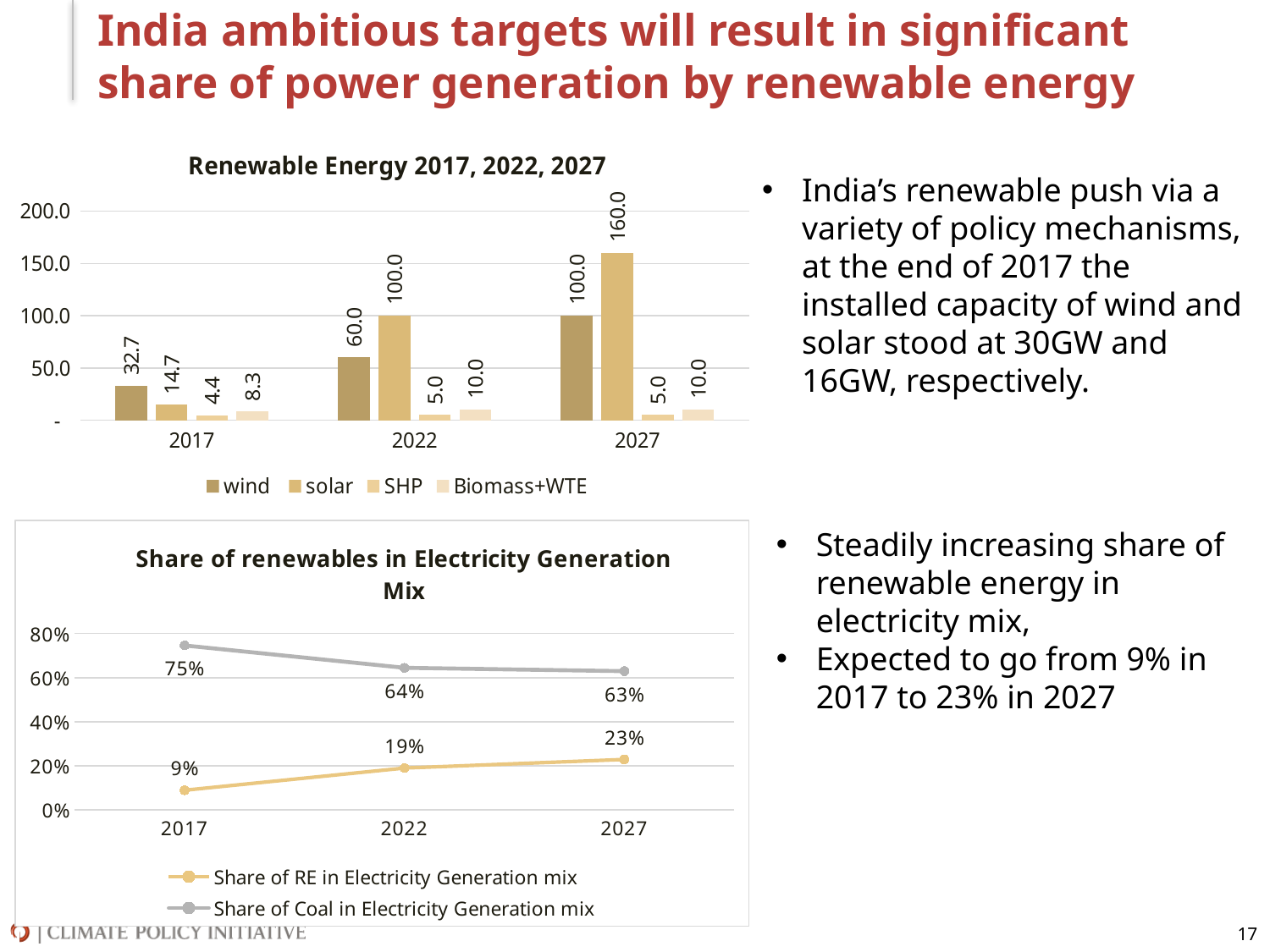
In the 'Renewable Energy 2017, 2022, 2027' chart, what is the value for wind in 2017? 32.7 In the 'Renewable Energy 2017, 2022, 2027' chart, what is the value for solar in 2027? 160.0 What kind of chart is 'Renewable Energy 2017, 2022, 2027'? bar chart In the 'Renewable Energy 2017, 2022, 2027' chart, what is the value for Biomass+WTE in 2022? 10.0 In the 'Renewable Energy 2017, 2022, 2027' chart, which series has the highest value in 2027? solar In the 'Share of renewables in Electricity Generation Mix' chart, what is the Share of RE in Electricity Generation mix in 2022? 19% In the 'Renewable Energy 2017, 2022, 2027' chart, what is the difference between the solar values for 2027 and 2022? 60.0 In the 'Share of renewables in Electricity Generation Mix' chart, what is the Share of Coal in Electricity Generation mix in 2017? 75% In the 'Renewable Energy 2017, 2022, 2027' chart, which series has the lowest value in 2017? SHP In the 'Renewable Energy 2017, 2022, 2027' chart, how many series does the legend list? 4 In the 'Share of renewables in Electricity Generation Mix' chart, what is the difference between the Share of RE in 2027 and in 2017? 14% In the 'Share of renewables in Electricity Generation Mix' chart, does the Share of Coal in Electricity Generation mix rise or fall from 2017 to 2027? fall